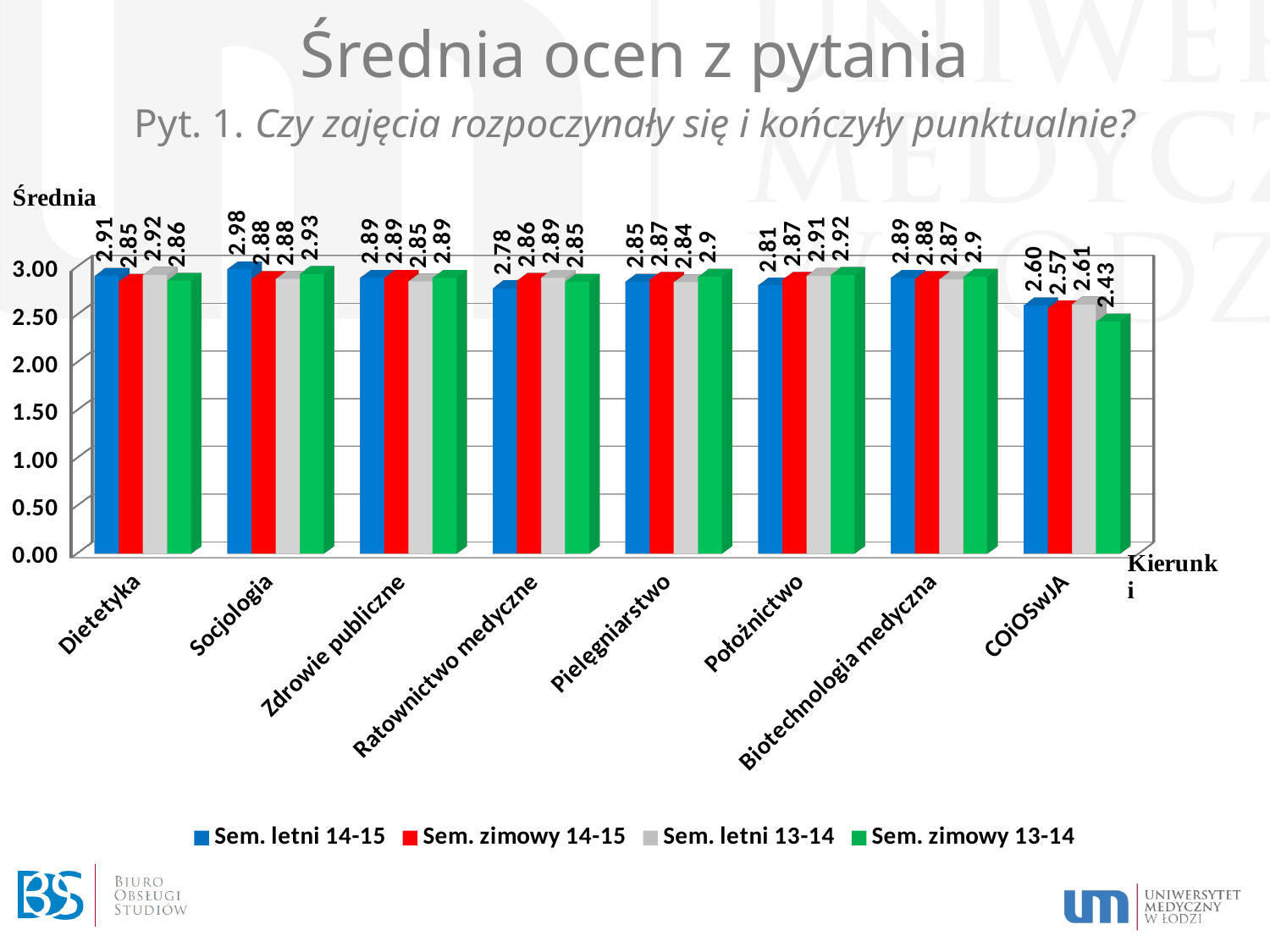
What is the value for COiOSwJA in the Sem. zimowy 13-14 series? 2.43 Which category has the lowest value in the Sem. zimowy 13-14 series? COiOSwJA What is the value for Socjologia in the Sem. letni 14-15 series? 2.98 What is the value for Położnictwo in the Sem. letni 13-14 series? 2.91 How many categories (kierunki) are shown on the x axis? 8 In the Sem. letni 14-15 series, which is larger: Dietetyka or Ratownictwo medyczne? Dietetyka How many series does the legend list? 4 What kind of chart is shown on the slide? Bar chart Which category has the highest value in the Sem. letni 14-15 series? Socjologia What is the value for Ratownictwo medyczne in the Sem. letni 14-15 series? 2.78 Is the Sem. zimowy 13-14 value for COiOSwJA greater or less than 2.50? less What is the difference between the Sem. letni 14-15 values for Socjologia and COiOSwJA? 0.38